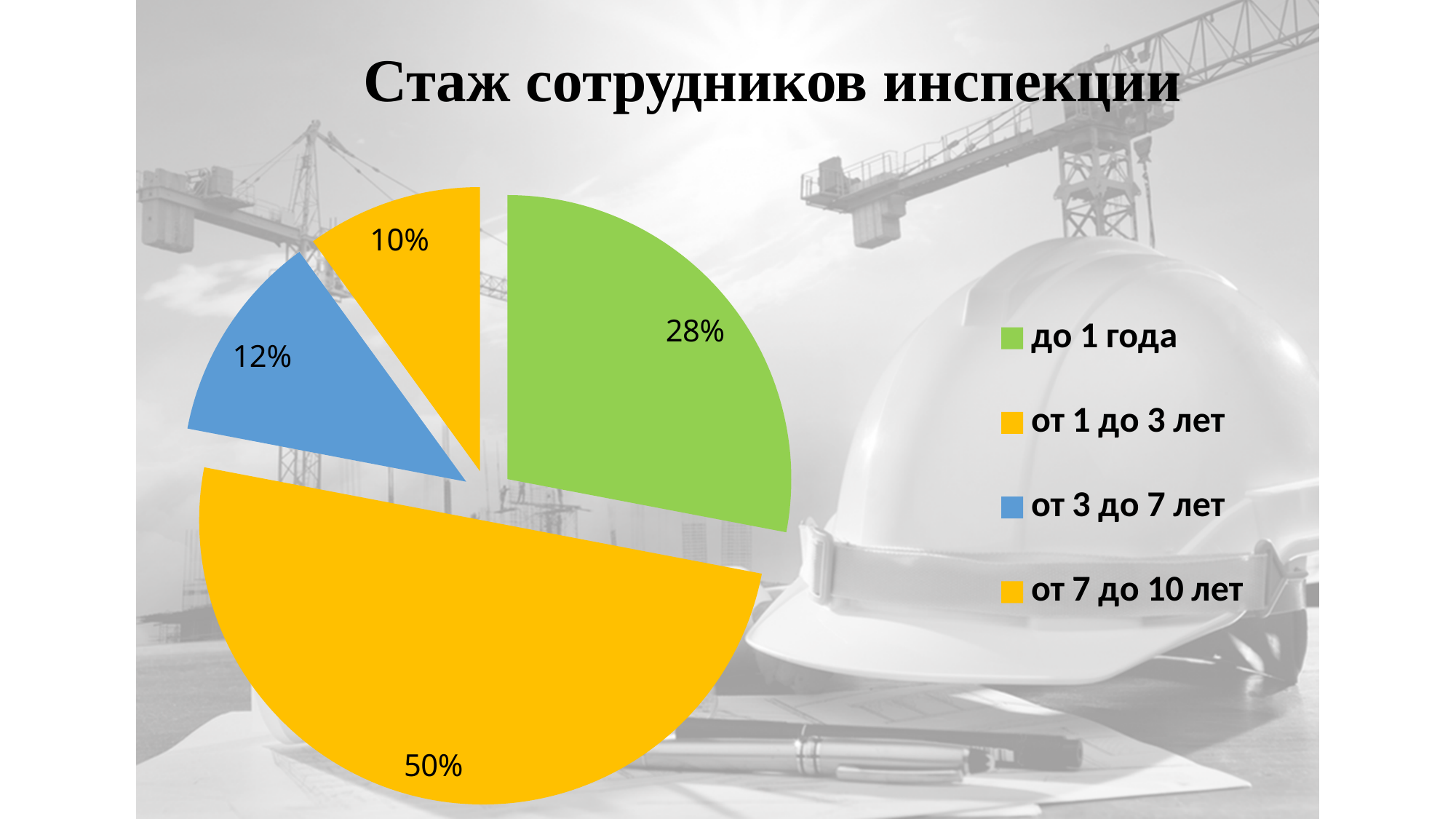
What share of the pie is labelled for the category 'от 1 до 3 лет'? 50% Which category has the largest slice of the pie? от 1 до 3 лет What share of the pie is labelled for the category 'от 7 до 10 лет'? 10% Which is larger, the 'от 3 до 7 лет' slice or the 'от 7 до 10 лет' slice? от 3 до 7 лет What is the difference in percentage points between the 'от 1 до 3 лет' slice and the 'до 1 года' slice? 22% What is the title of the chart? Стаж сотрудников инспекции What share of the pie is labelled for the category 'до 1 года'? 28% Which category has the smallest slice of the pie? от 7 до 10 лет What kind of chart is shown on the slide? pie chart What colour is the slice for 'от 3 до 7 лет'? blue How many categories does the legend list? 4